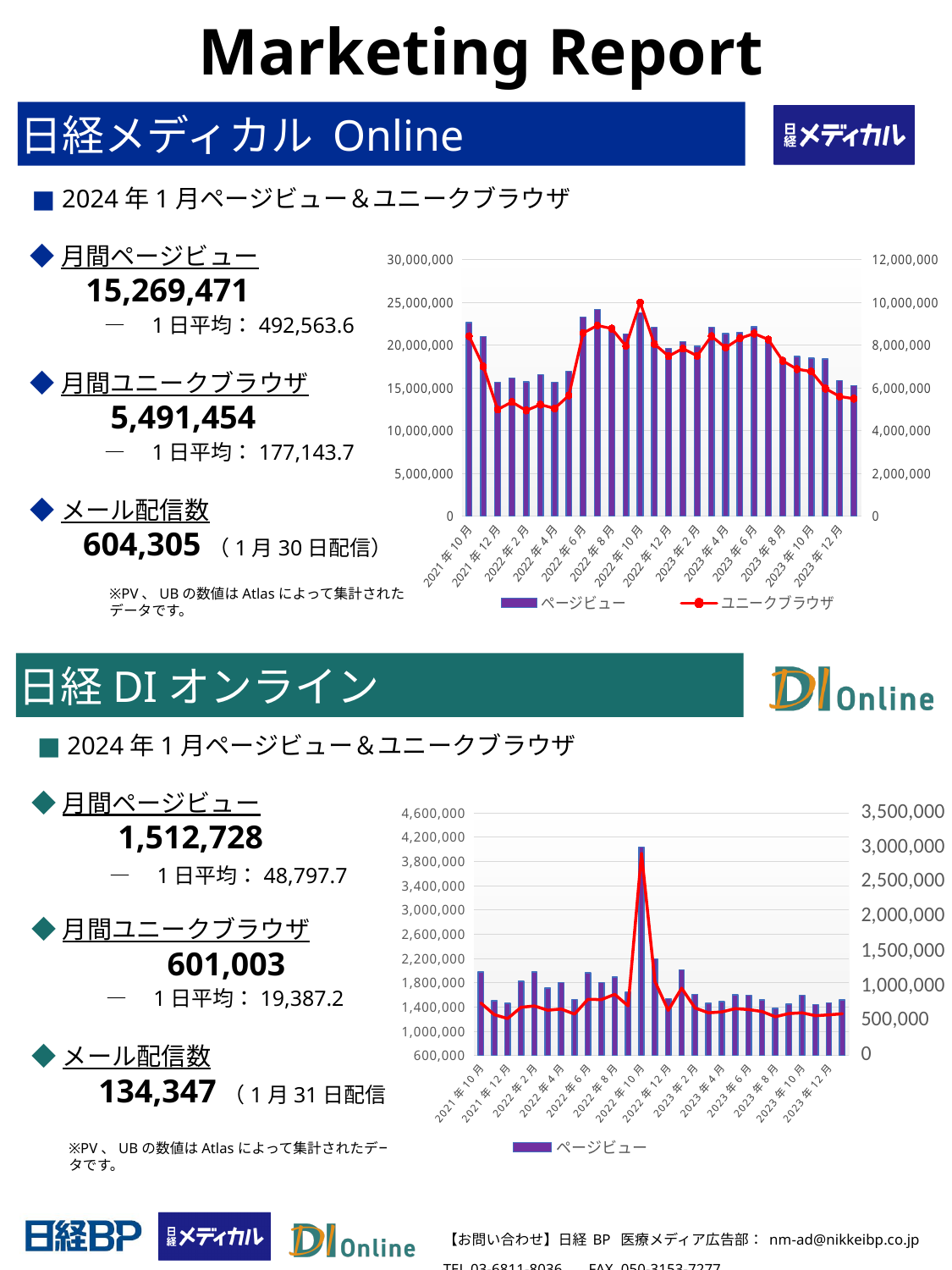
In the bottom (日経DIオンライン) chart, is the ページビュー bar for 2022年10月 greater or less than 3,400,000? greater What is the highest tick value on the right-hand axis of the top (日経メディカル Online) chart? 12,000,000 In the top (日経メディカル Online) chart, which is larger, the ページビュー bar for 2022年8月 or for 2023年12月? 2022年8月 In the top (日経メディカル Online) chart, which month has the highest ユニークブラウザ value? 2022年10月 What kind of chart is the 日経メディカル Online chart at the top of the slide? A bar chart combined with a line chart In the bottom (日経DIオンライン) chart, is the ページビュー bar for 2023年12月 greater or less than 2,200,000? less In the top (日経メディカル Online) chart, is the ページビュー bar for 2021年12月 greater or less than 20,000,000? less How many series does the legend of the bottom (日経DIオンライン) chart list? 1 In the bottom (日経DIオンライン) chart, which month has the highest ページビュー bar? 2022年10月 How many series does the legend of the top (日経メディカル Online) chart list? 2 In the top (日経メディカル Online) chart, do the ページビュー bars rise or fall from 2023年6月 to 2023年12月? fall